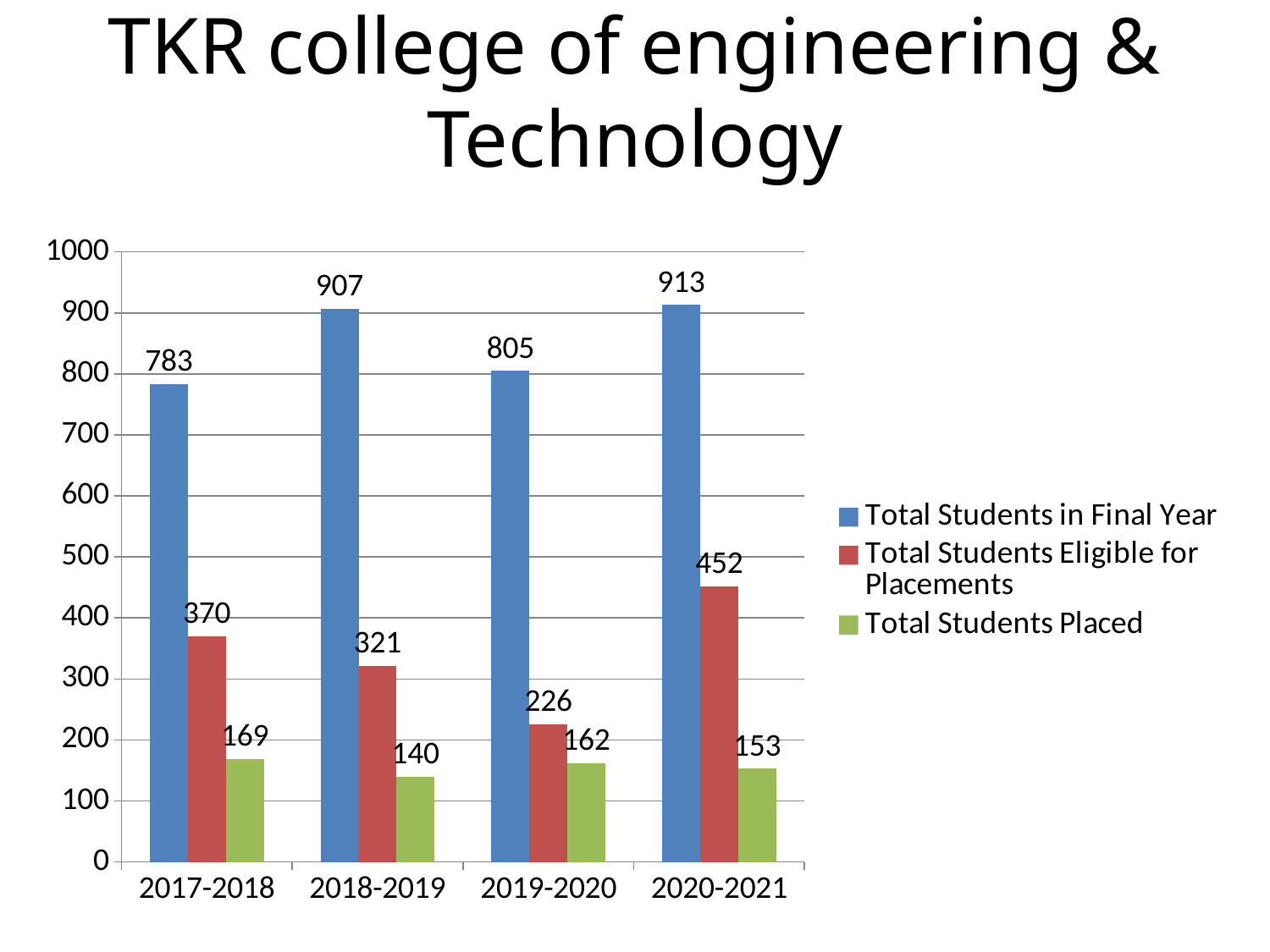
What is the value for Total Students Placed in 2017-2018? 169 How many series does the legend list? 3 Which year has the highest value for Total Students in Final Year? 2020-2021 Which colour represents Total Students Placed in the chart? green How many years are shown on the x axis? 4 Which year has the lowest value for Total Students Placed? 2018-2019 Is the value for Total Students Eligible for Placements in 2019-2020 greater or less than 300? less Which is larger: Total Students Eligible for Placements in 2017-2018 or in 2018-2019? 2017-2018 What kind of chart is shown on the slide? bar chart What is the difference between Total Students in Final Year and Total Students Eligible for Placements in 2019-2020? 579 What is the value for Total Students in Final Year in 2018-2019? 907 What is the value for Total Students Eligible for Placements in 2020-2021? 452